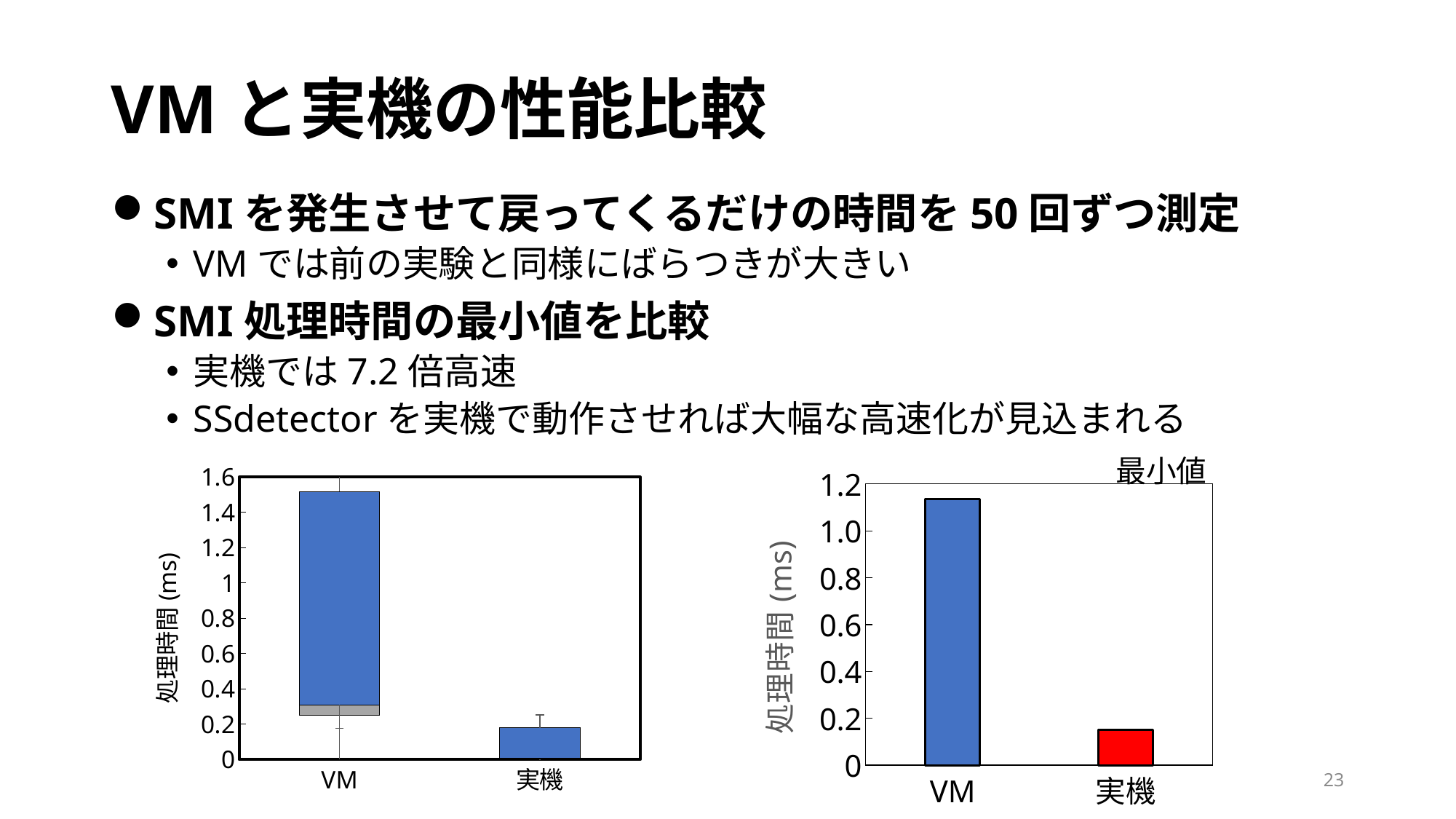
In the left-hand chart, is the top of the box for VM greater or less than 1.4? greater In the right-hand chart titled 最小値, what colour is the bar for 実機? red In the right-hand chart titled 最小値, which is larger, the value for VM or the value for 実機? VM In the right-hand chart titled 最小値, is the value for 実機 greater or less than 0.4? less In the right-hand chart titled 最小値, is the value for VM greater or less than 1.0? greater What kind of chart is the right-hand chart titled 最小値? bar chart In the right-hand chart titled 最小値, which category has the highest value? VM In the right-hand chart titled 最小値, how many categories are shown on the x axis? 2 What is the y-axis label of the right-hand chart titled 最小値? 処理時間 (ms) In the left-hand chart, how many categories are shown on the x axis? 2 In the right-hand chart titled 最小値, which category has the lowest value? 実機